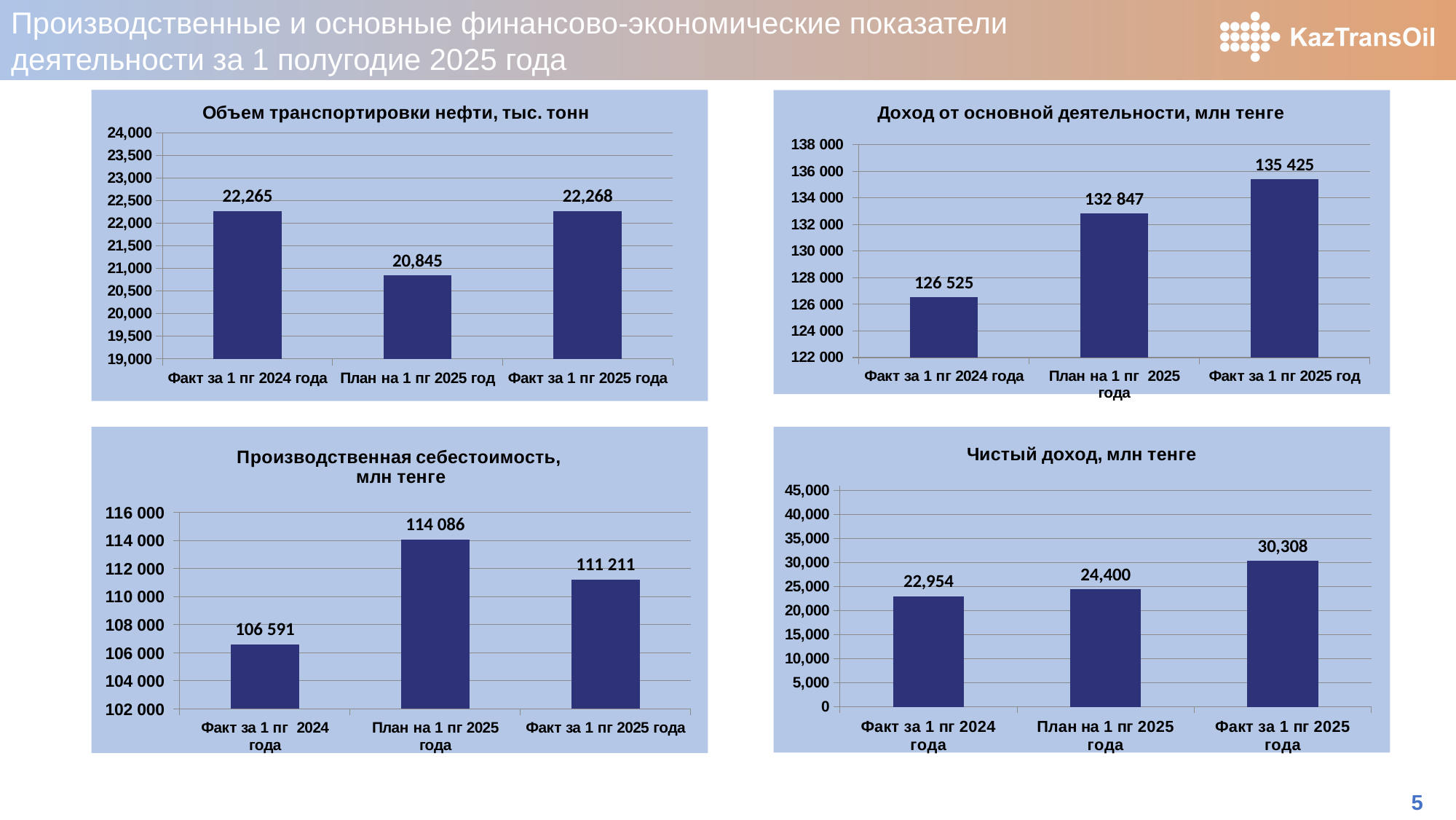
In the chart 'Производственная себестоимость, млн тенге', which is larger: 'План на 1 пг 2025 года' or 'Факт за 1 пг 2025 года'? План на 1 пг 2025 года In the chart 'Чистый доход, млн тенге', what is the value for 'Факт за 1 пг 2025 года'? 30,308 In the chart 'Производственная себестоимость, млн тенге', which category has the highest value? План на 1 пг 2025 года In the chart 'Доход от основной деятельности, млн тенге', do the values rise or fall from left to right? rise In the chart 'Объем транспортировки нефти, тыс. тонн', what is the value for 'План на 1 пг 2025 год'? 20,845 In the chart 'Доход от основной деятельности, млн тенге', what is the difference between 'Факт за 1 пг 2025 год' and 'Факт за 1 пг 2024 года'? 8 900 In the chart 'Доход от основной деятельности, млн тенге', what is the value for 'Факт за 1 пг 2025 год'? 135 425 In the chart 'Чистый доход, млн тенге', what is the difference between 'Факт за 1 пг 2025 года' and 'Факт за 1 пг 2024 года'? 7,354 In the chart 'Чистый доход, млн тенге', is the value for 'План на 1 пг 2025 года' greater or less than 25,000? less In the chart 'Производственная себестоимость, млн тенге', what is the value for 'Факт за 1 пг 2024 года'? 106 591 In the chart 'Объем транспортировки нефти, тыс. тонн', which category has the lowest value? План на 1 пг 2025 год How many categories are shown in the chart 'Чистый доход, млн тенге'? 3